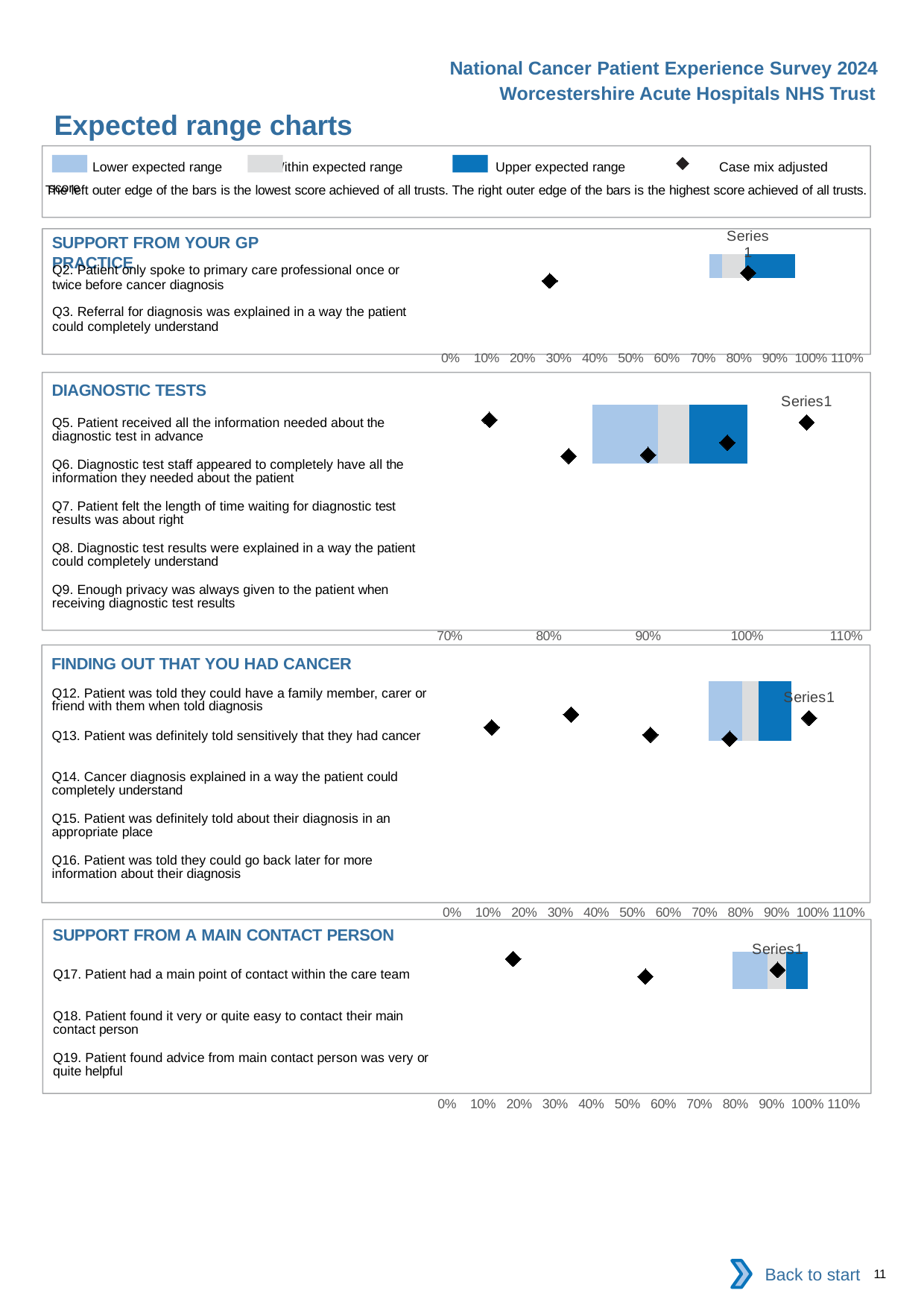
How many expected range charts are shown on the slide? 4 In the SUPPORT FROM A MAIN CONTACT PERSON chart, what is the highest value shown on the horizontal axis? 110% In the DIAGNOSTIC TESTS chart, what is the lowest value shown on the horizontal axis? 70% According to the legend, which colour represents the upper expected range? dark blue How many questions are listed in the SUPPORT FROM A MAIN CONTACT PERSON chart? 3 How many questions are listed in the SUPPORT FROM YOUR GP PRACTICE chart? 2 According to the legend, what does the diamond marker represent? Case mix adjusted score What kind of chart is used for the expected range charts on this slide? bar chart